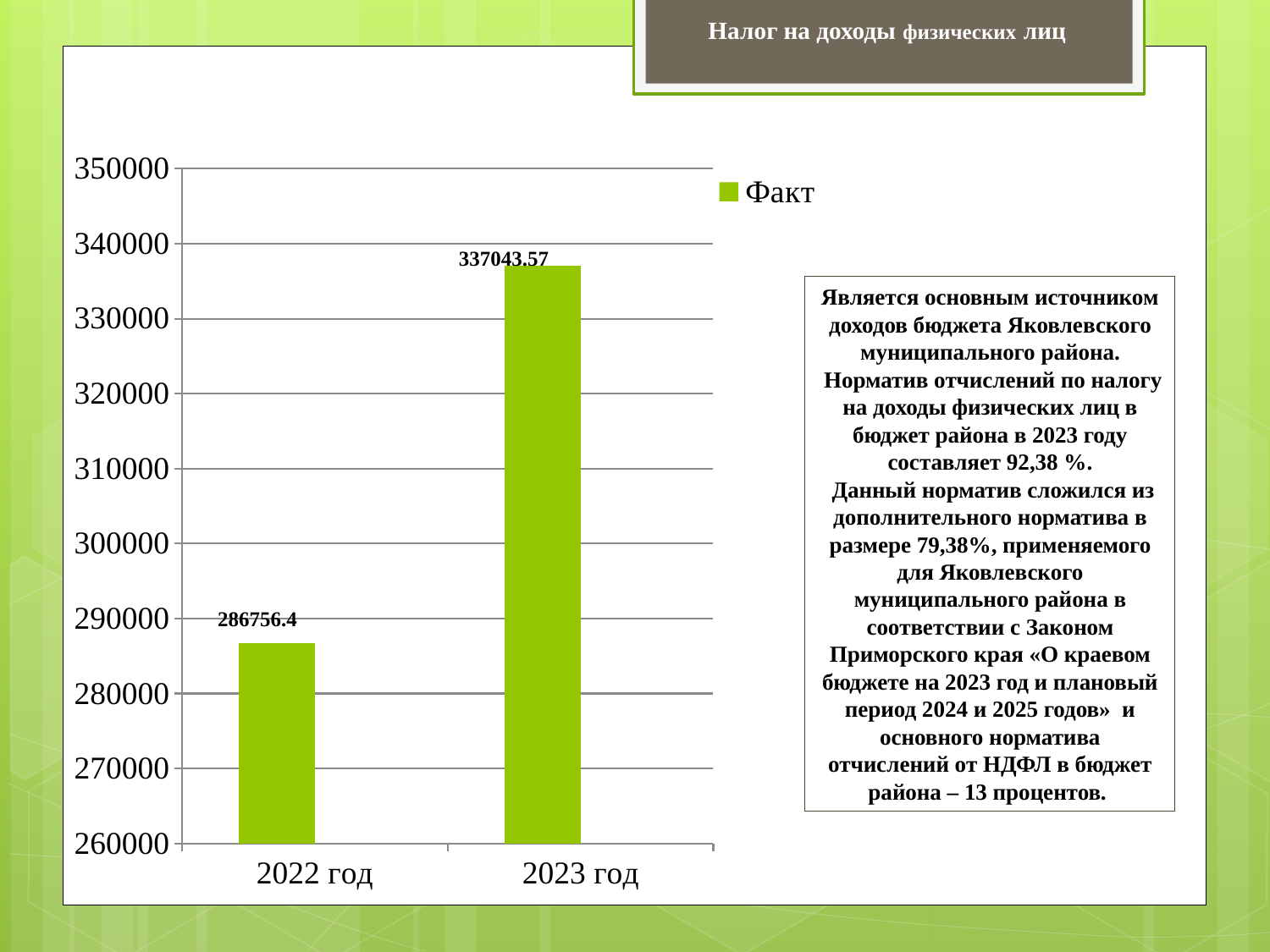
Which year has the lowest value? 2022 год What is the difference between the values for 2023 год and 2022 год? 50287.17 Is the value for 2022 год greater or less than 290000? less Which is larger, the value for 2022 год or the value for 2023 год? 2023 год How many series does the legend list? 1 What is the name of the series shown in the legend? Факт How many categories are shown on the x axis? 2 What kind of chart is shown on the slide? bar chart What is the value for 2023 год? 337043.57 Which year has the highest value? 2023 год What is the value for 2022 год? 286756.4 Is the value for 2023 год greater or less than 330000? greater